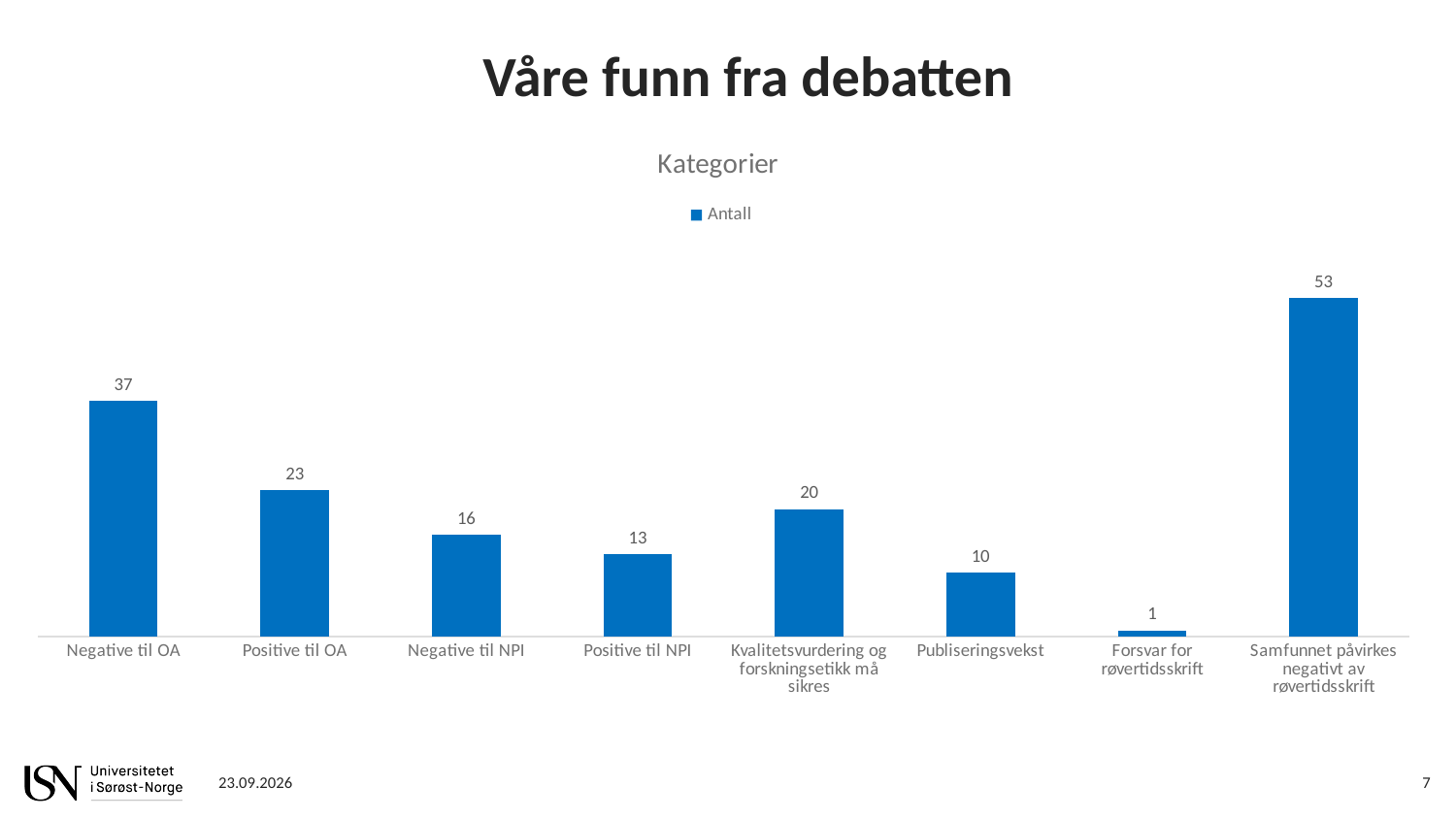
Which category has the highest value? Samfunnet påvirkes negativt av røvertidsskrift What is the value for Kvalitetsvurdering og forskningsetikk må sikres? 20 What is the title of the chart? Kategorier Which is larger, the value for Negative til NPI or the value for Positive til NPI? Negative til NPI How many categories are shown on the x axis? 8 What is the name of the series in the legend? Antall Which category has the lowest value? Forsvar for røvertidsskrift What is the difference between the values for Negative til OA and Positive til OA? 14 How many series does the legend list? 1 What is the value for Forsvar for røvertidsskrift? 1 What kind of chart is shown? bar chart What is the value for Negative til OA? 37